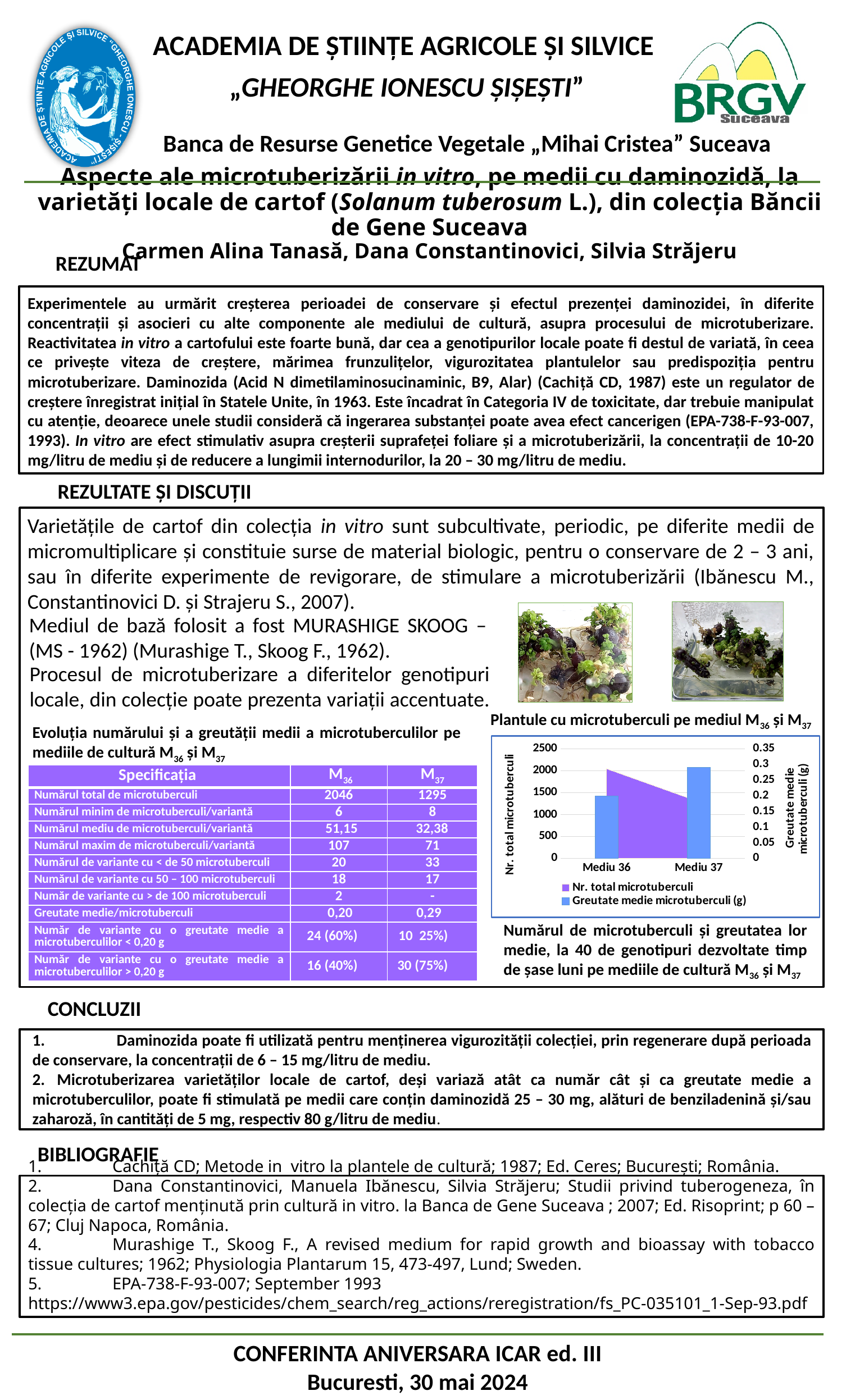
Is the Greutate medie microtuberculi (g) value for Mediu 37 greater or less than 0.25? greater How many categories are shown on the x axis of the chart? 2 Does the Nr. total microtuberculi series rise or fall from Mediu 36 to Mediu 37? fall Is the Greutate medie microtuberculi (g) value for Mediu 36 or for Mediu 37 larger? Mediu 37 Which category has the lower value for Greutate medie microtuberculi (g)? Mediu 36 What colour are the bars for Greutate medie microtuberculi (g) in the chart? blue Is the Nr. total microtuberculi value for Mediu 37 greater or less than 1500? less What is the title of the left vertical axis of the chart? Nr. total microtuberculi Which category has the higher value for Nr. total microtuberculi? Mediu 36 Is the Greutate medie microtuberculi (g) value for Mediu 36 greater or less than 0.25? less How many series does the chart legend list? 2